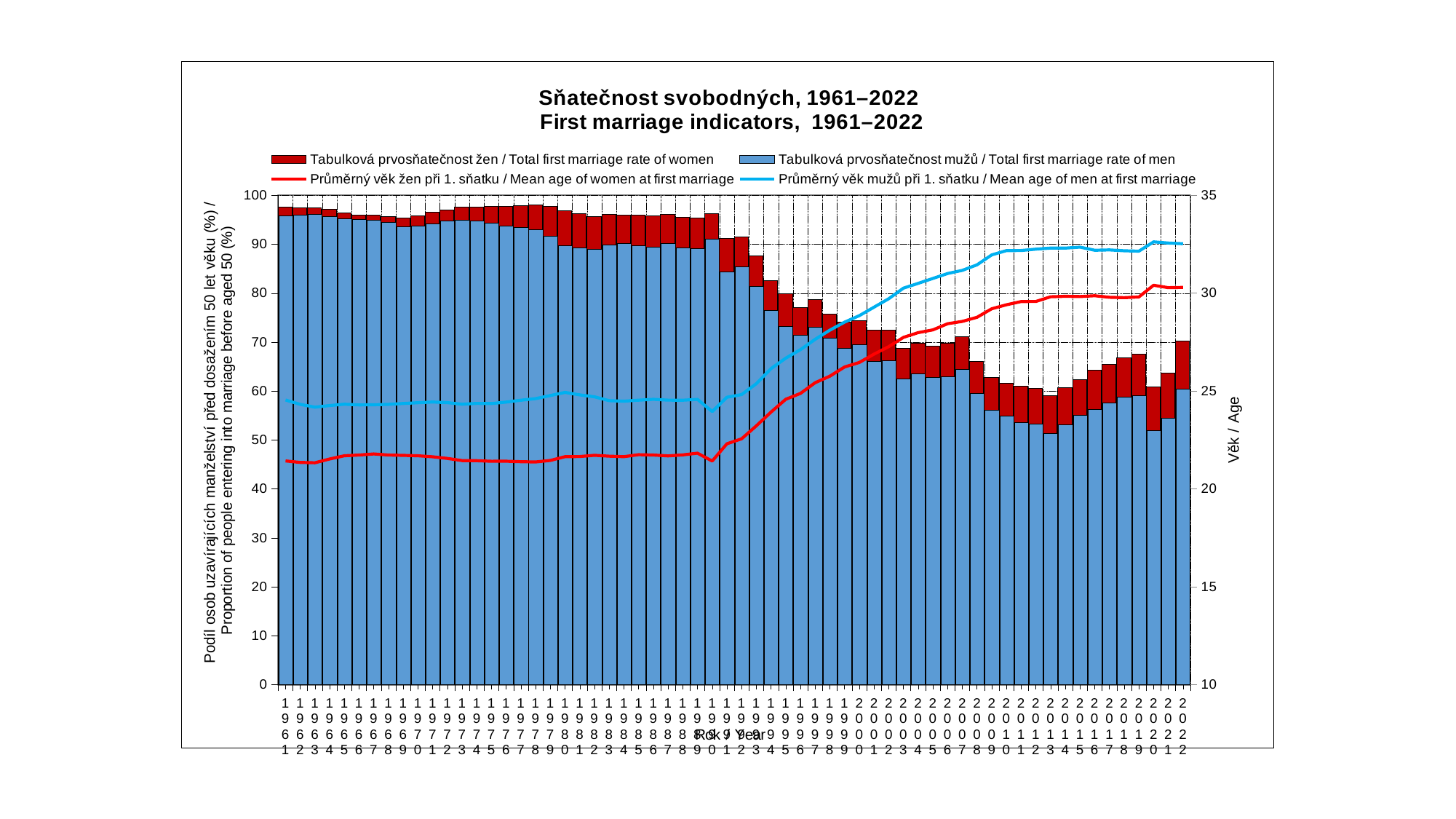
In 2022, which is higher: the mean age of men at first marriage or the mean age of women at first marriage? Mean age of men at first marriage Does the mean age of men at first marriage rise or fall from 1961 to 2022? Rise Does the total first marriage rate of men rise or fall from 1961 to 2022? Fall How many series does the legend list? 4 Is the mean age of women at first marriage in 1961 greater or less than 25? less Is the total first marriage rate of men in 2013 greater or less than 60? less What is the label of the right-hand vertical axis? Věk / Age How many years are plotted along the x axis? 62 Is the mean age of men at first marriage in 2022 greater or less than 30? greater What kind of chart is shown on the slide? A combined bar and line chart What is the title of the chart? Sňatečnost svobodných, 1961–2022 First marriage indicators, 1961–2022